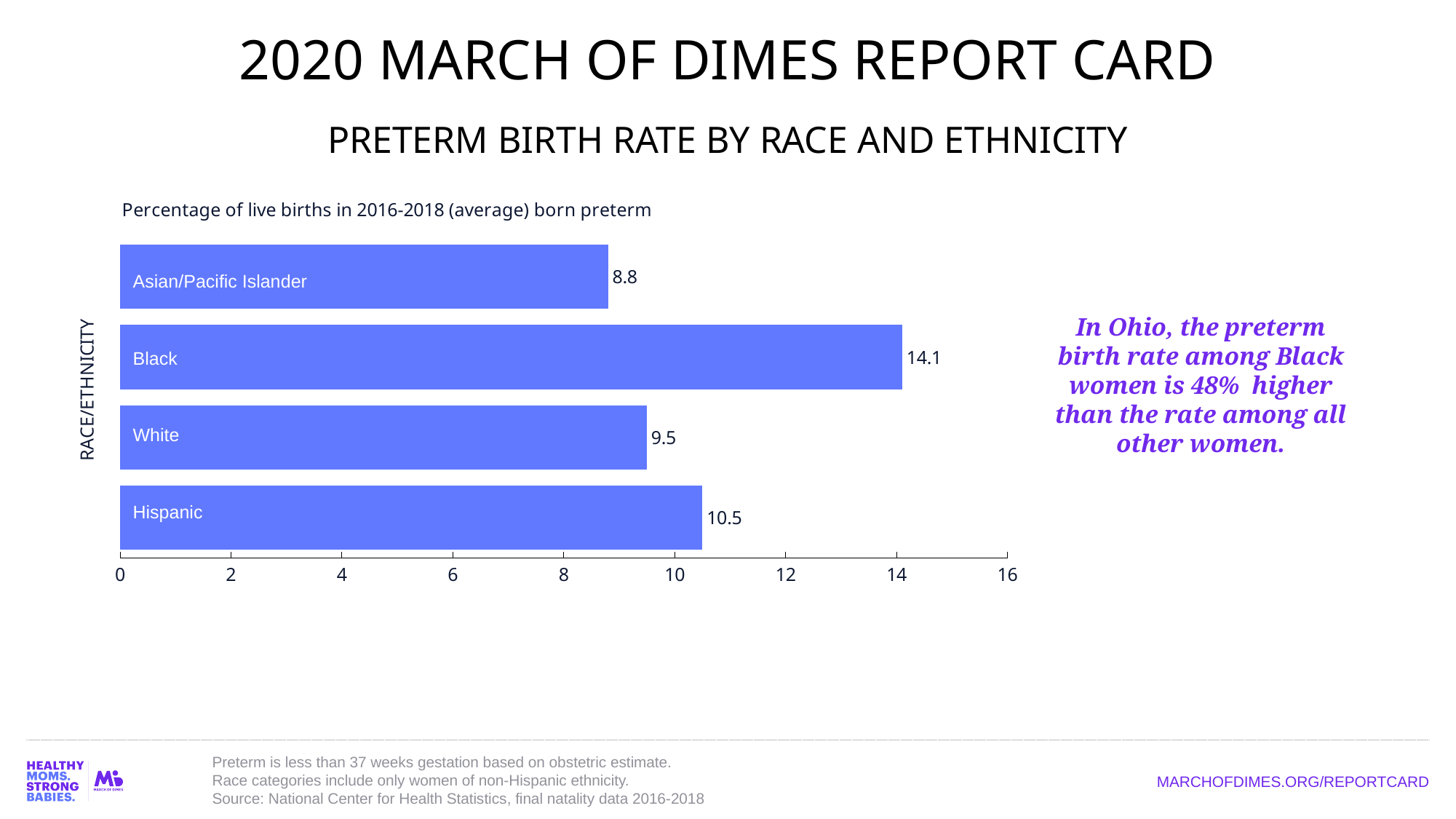
Which is larger, the preterm birth rate for Hispanic women or for White women? Hispanic How many race/ethnicity categories are shown on the chart? 4 What is the preterm birth rate for White women shown on the chart? 9.5 What is the preterm birth rate for Hispanic women shown on the chart? 10.5 What is the preterm birth rate for Asian/Pacific Islander women shown on the chart? 8.8 What kind of chart is shown on the slide? Bar chart Which race/ethnicity category has the highest preterm birth rate? Black Which race/ethnicity category has the lowest preterm birth rate? Asian/Pacific Islander What is the label of the vertical axis of the chart? RACE/ETHNICITY What is the difference between the preterm birth rate for Black women and for White women? 4.6 Is the preterm birth rate for Black women greater or less than 12? greater What is the preterm birth rate for Black women shown on the chart? 14.1